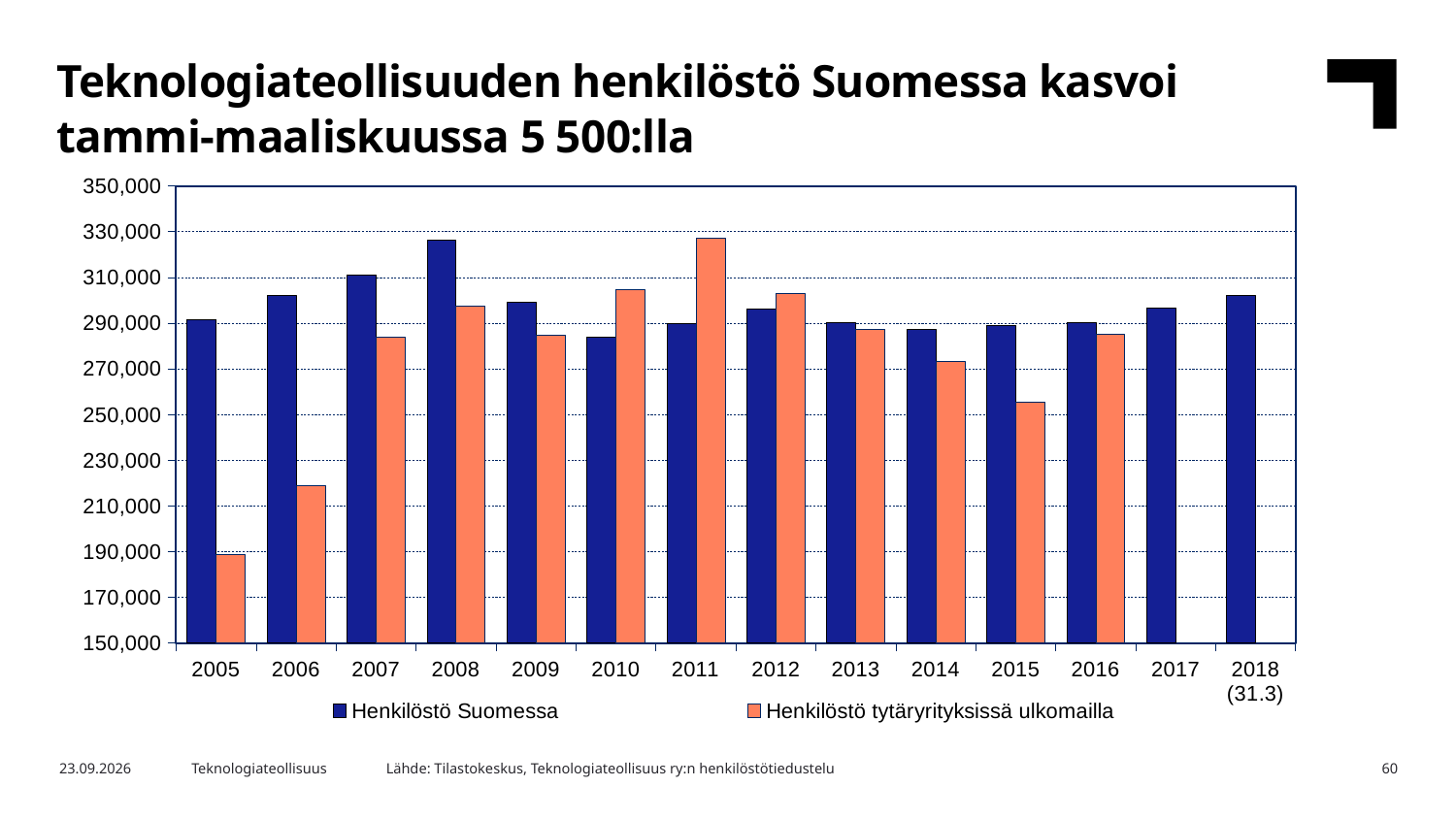
How many years are shown on the x axis? 14 What kind of chart is shown on the slide? Bar chart Does the value for Henkilöstö tytäryrityksissä ulkomailla rise or fall from 2011 to 2015? fall Is the value for Henkilöstö tytäryrityksissä ulkomailla in 2006 greater or less than 230,000? less In which year is the value for Henkilöstö Suomessa highest? 2008 In which year is the value for Henkilöstö tytäryrityksissä ulkomailla lowest? 2005 In 2005, which series has the larger value: Henkilöstö Suomessa or Henkilöstö tytäryrityksissä ulkomailla? Henkilöstö Suomessa In 2011, which series has the larger value: Henkilöstö Suomessa or Henkilöstö tytäryrityksissä ulkomailla? Henkilöstö tytäryrityksissä ulkomailla In which year is the value for Henkilöstö tytäryrityksissä ulkomailla highest? 2011 How many series does the legend list? 2 Is the value for Henkilöstö Suomessa in 2008 greater or less than 310,000? greater Is the value for Henkilöstö tytäryrityksissä ulkomailla in 2015 greater or less than 270,000? less